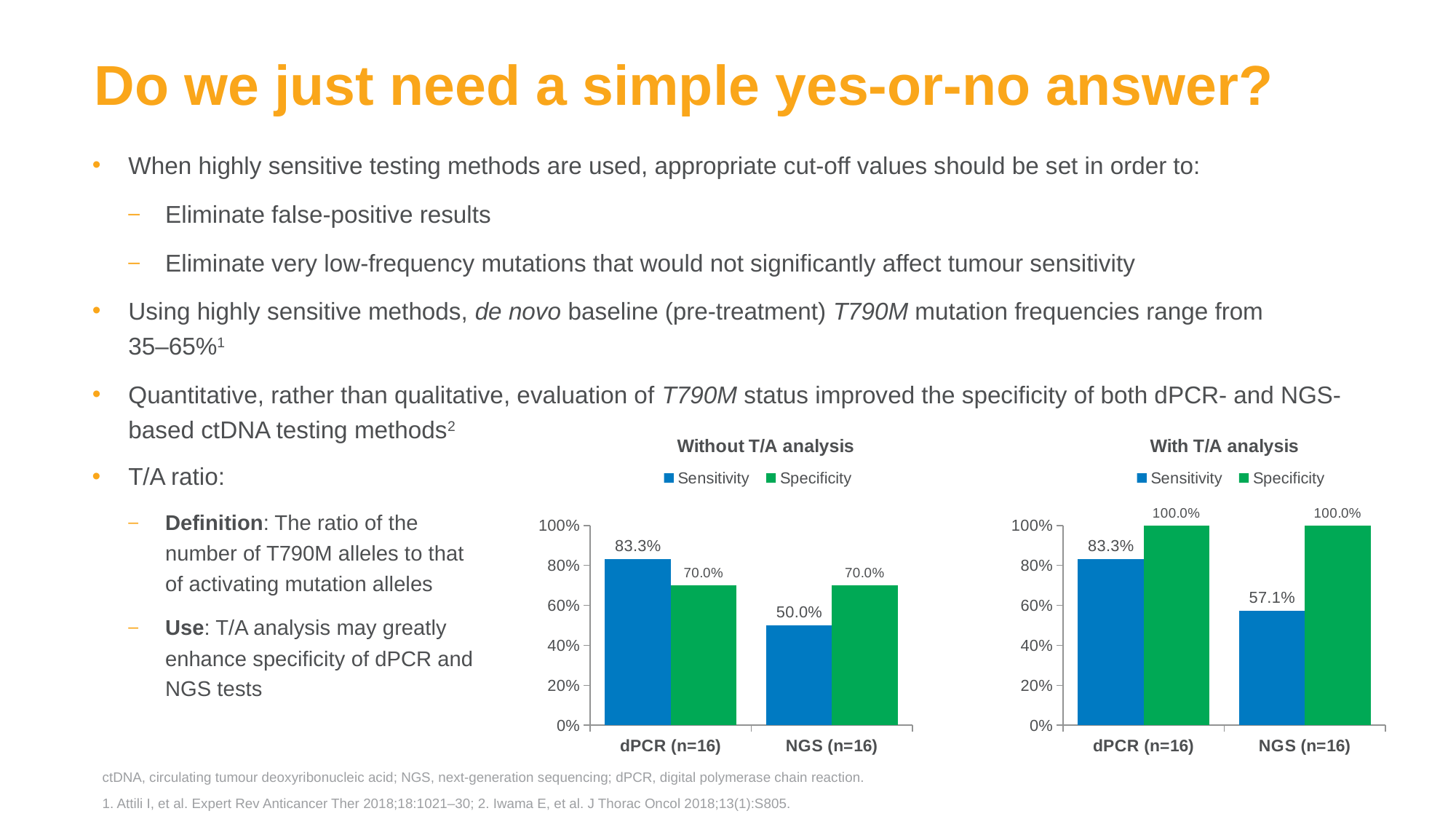
In the 'With T/A analysis' chart, what is the Sensitivity value for NGS (n=16)? 57.1% In the 'With T/A analysis' chart, is the Sensitivity for dPCR (n=16) larger or smaller than the Sensitivity for NGS (n=16)? larger In the 'Without T/A analysis' chart, what is the Sensitivity value for NGS (n=16)? 50.0% In the 'Without T/A analysis' chart, is the Sensitivity value for NGS (n=16) greater or less than 60%? less In the 'With T/A analysis' chart, what is the Specificity value for NGS (n=16)? 100.0% In the 'Without T/A analysis' chart, what is the difference between the Sensitivity and Specificity values for dPCR (n=16)? 13.3% How many series does the legend of the 'With T/A analysis' chart list? 2 What kind of chart is the 'Without T/A analysis' chart? bar chart In the 'Without T/A analysis' chart, what is the Sensitivity value for dPCR (n=16)? 83.3% In the 'With T/A analysis' chart, what is the difference between the Specificity and Sensitivity values for NGS (n=16)? 42.9% In the 'Without T/A analysis' chart, which category has the lowest Sensitivity? NGS (n=16) In the 'With T/A analysis' chart, what colour are the Specificity bars? green